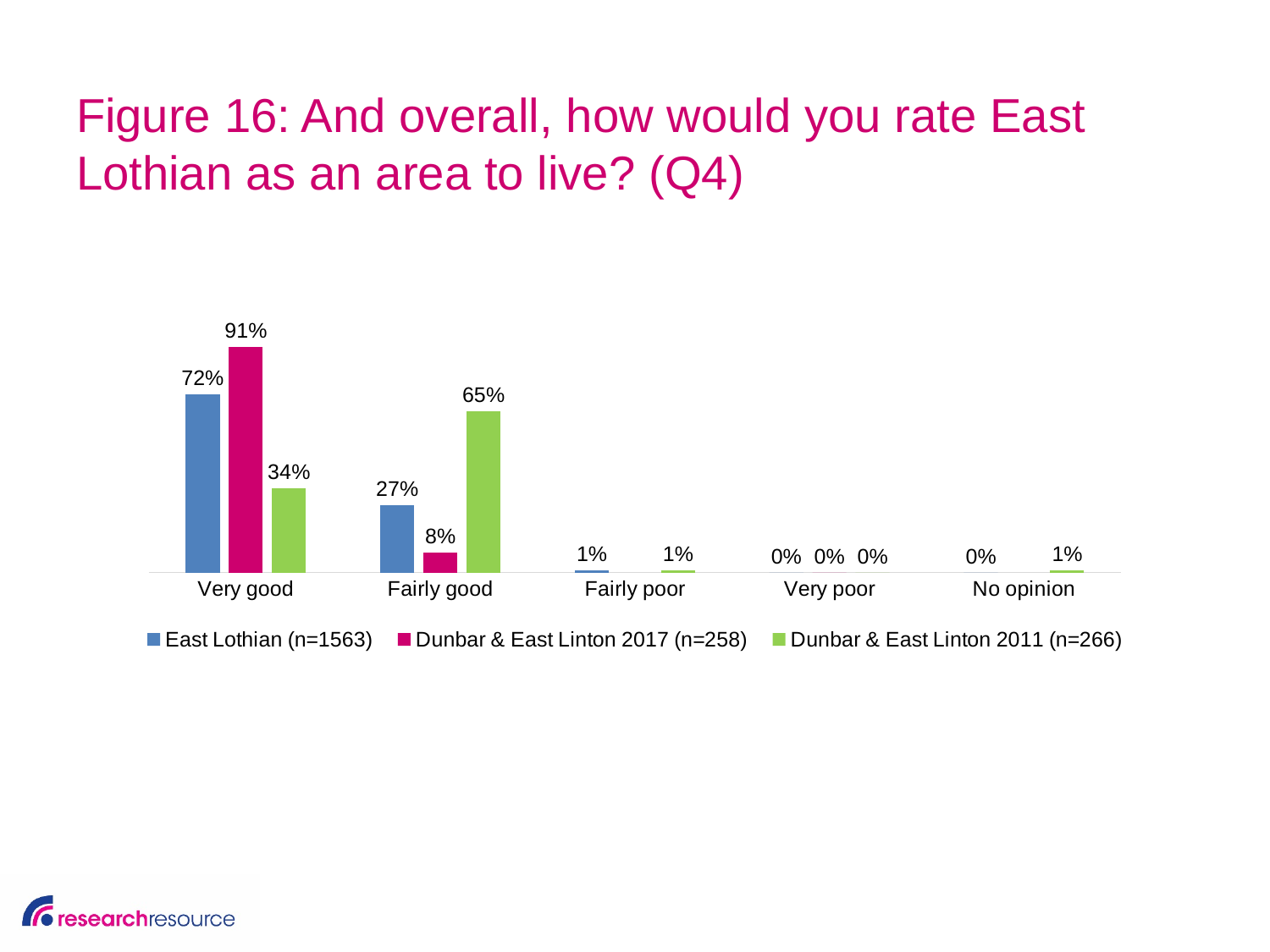
What is the value for Dunbar & East Linton 2017 (n=258) in the 'Very good' category? 91% What is the difference between the East Lothian and Dunbar & East Linton 2017 values for 'Fairly good'? 19 percentage points Which series has the highest value in the 'Very good' category? Dunbar & East Linton 2017 (n=258) Which is larger: the East Lothian value for 'Very good' or the Dunbar & East Linton 2011 value for 'Very good'? East Lothian How many series does the legend list? 3 What is the value for Dunbar & East Linton 2011 (n=266) in the 'Fairly good' category? 65% What is the value for Dunbar & East Linton 2017 (n=258) in the 'Fairly good' category? 8% What is the difference between the Dunbar & East Linton 2017 and Dunbar & East Linton 2011 values for 'Very good'? 57 percentage points Which category has the highest value for the Dunbar & East Linton 2011 (n=266) series? Fairly good What percentage of East Lothian (n=1563) respondents rated the area as 'Very good'? 72% How many rating categories are shown on the x axis? 5 What type of chart is shown on the slide? Bar chart